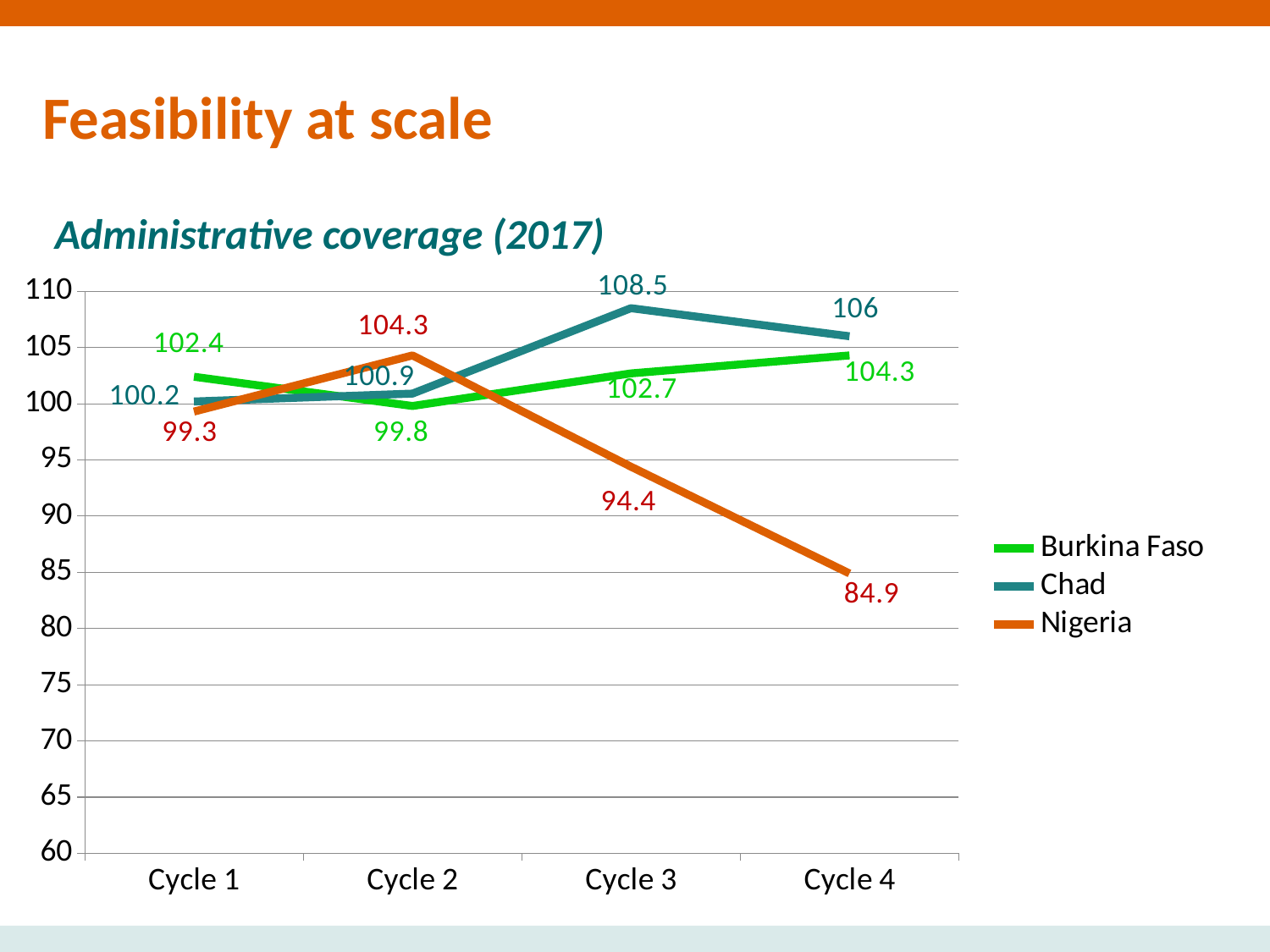
How much does Nigeria's value drop from Cycle 2 to Cycle 4? 19.4 At Cycle 1, which has the higher value, Burkina Faso or Chad? Burkina Faso In which cycle does Nigeria reach its highest value? Cycle 2 How many series does the legend list? 3 What is the value for Burkina Faso at Cycle 2? 99.8 How many cycles are shown on the x axis? 4 What is the value for Chad at Cycle 3? 108.5 In which cycle does Nigeria have its lowest value? Cycle 4 What is the difference between Chad and Burkina Faso at Cycle 3? 5.8 Does Nigeria's value rise or fall from Cycle 2 to Cycle 4? Fall What kind of chart is shown on the slide? Line chart What is the value for Nigeria at Cycle 4? 84.9